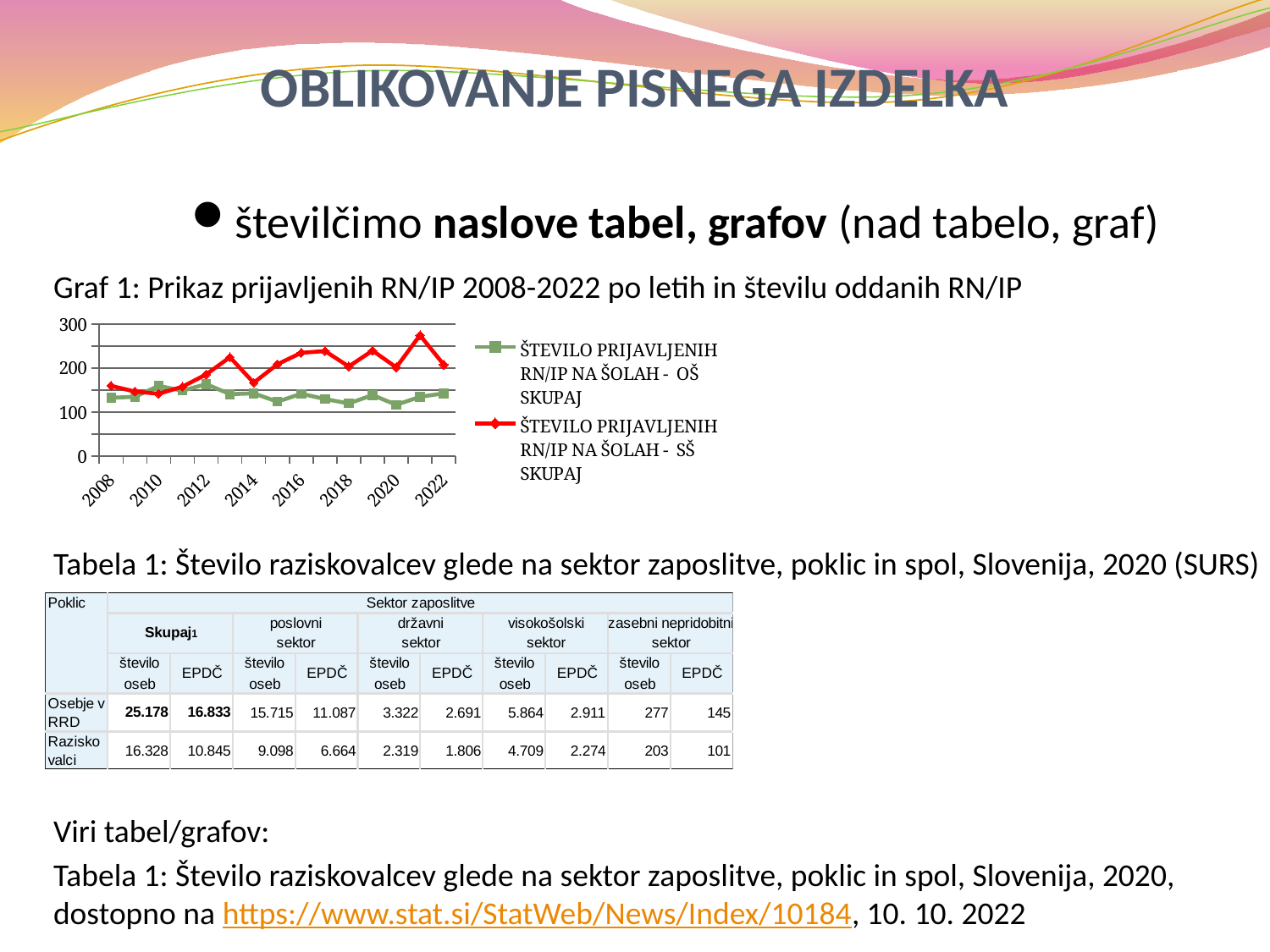
In Graf 1, is the value for ŠTEVILO PRIJAVLJENIH RN/IP NA ŠOLAH - SŠ SKUPAJ in 2021 greater or less than 200? greater What is the first year shown on the x axis of Graf 1? 2008 How many series does the legend of Graf 1 list? 2 In Graf 1, is the value for ŠTEVILO PRIJAVLJENIH RN/IP NA ŠOLAH - OŠ SKUPAJ in 2008 greater or less than 100? greater In Graf 1, does the ŠTEVILO PRIJAVLJENIH RN/IP NA ŠOLAH - SŠ SKUPAJ series generally rise or fall from 2008 to 2022? rise In Graf 1, is the value for ŠTEVILO PRIJAVLJENIH RN/IP NA ŠOLAH - SŠ SKUPAJ in 2008 greater or less than 200? less In Graf 1, which year has the highest value for ŠTEVILO PRIJAVLJENIH RN/IP NA ŠOLAH - SŠ SKUPAJ? 2021 What is the title of the chart on the slide? Graf 1: Prikaz prijavljenih RN/IP 2008-2022 po letih in številu oddanih RN/IP How many years are plotted along the x axis of Graf 1? 15 What kind of chart is Graf 1 on the slide? line chart In Graf 1, which series has the larger value in 2016, OŠ SKUPAJ or SŠ SKUPAJ? SŠ SKUPAJ